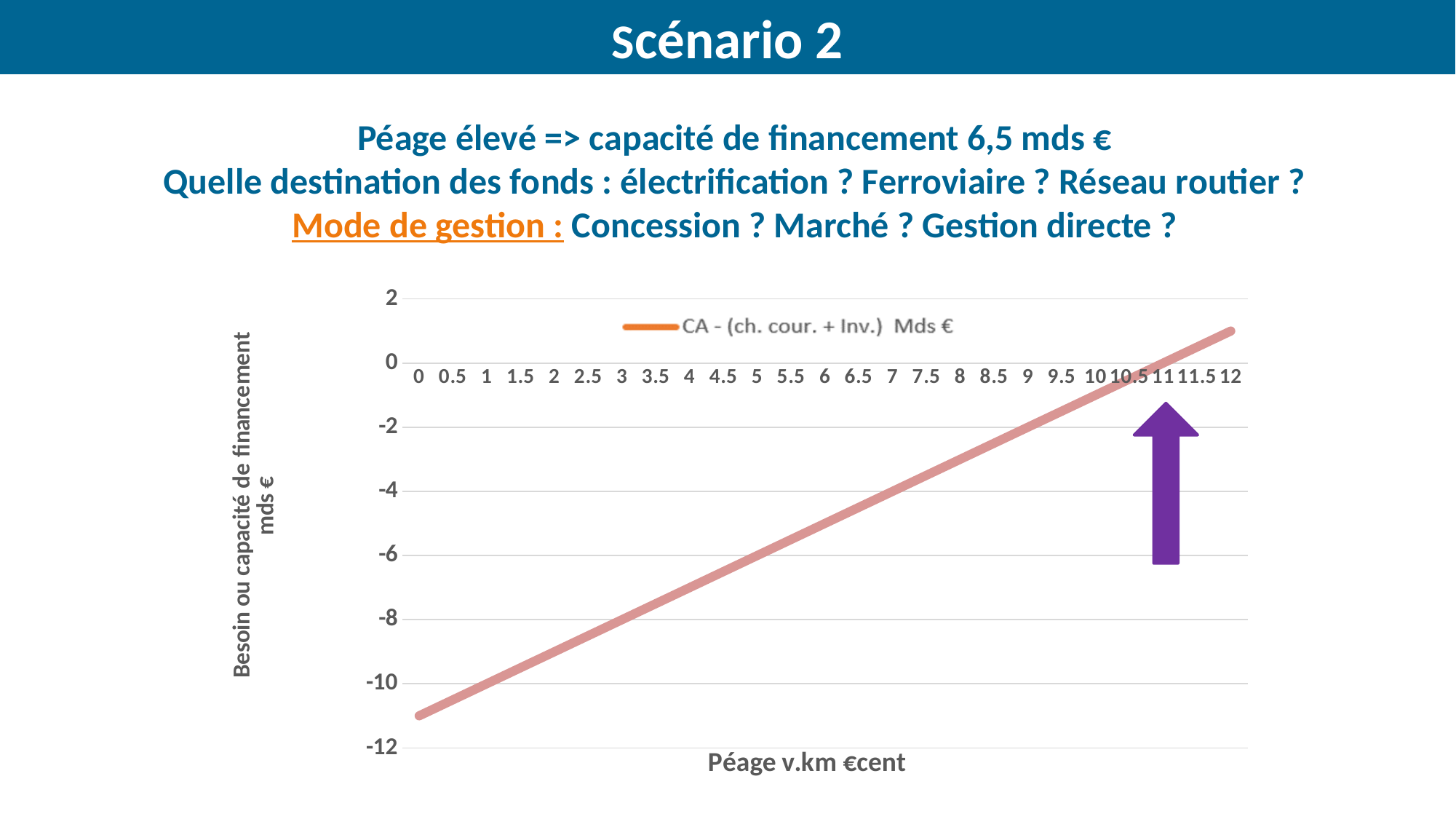
Is the value of the line at x = 0 greater or less than -10? less Is the value of the line at x = 12 greater or less than 0? greater Do the values of the line rise or fall as the x axis goes from 0 to 12? rise Is the value of the line at x = 2 greater or less than -8? less Which x value has the higher line value, 4 or 8? 8 How many series does the chart legend list? 1 How many tick labels are shown on the x axis of the chart? 25 What is the name of the series shown in the chart legend? CA - (ch. cour. + Inv.) Mds € What kind of chart is shown on the slide? line chart What is the title of the x axis of the chart? Péage v.km €cent